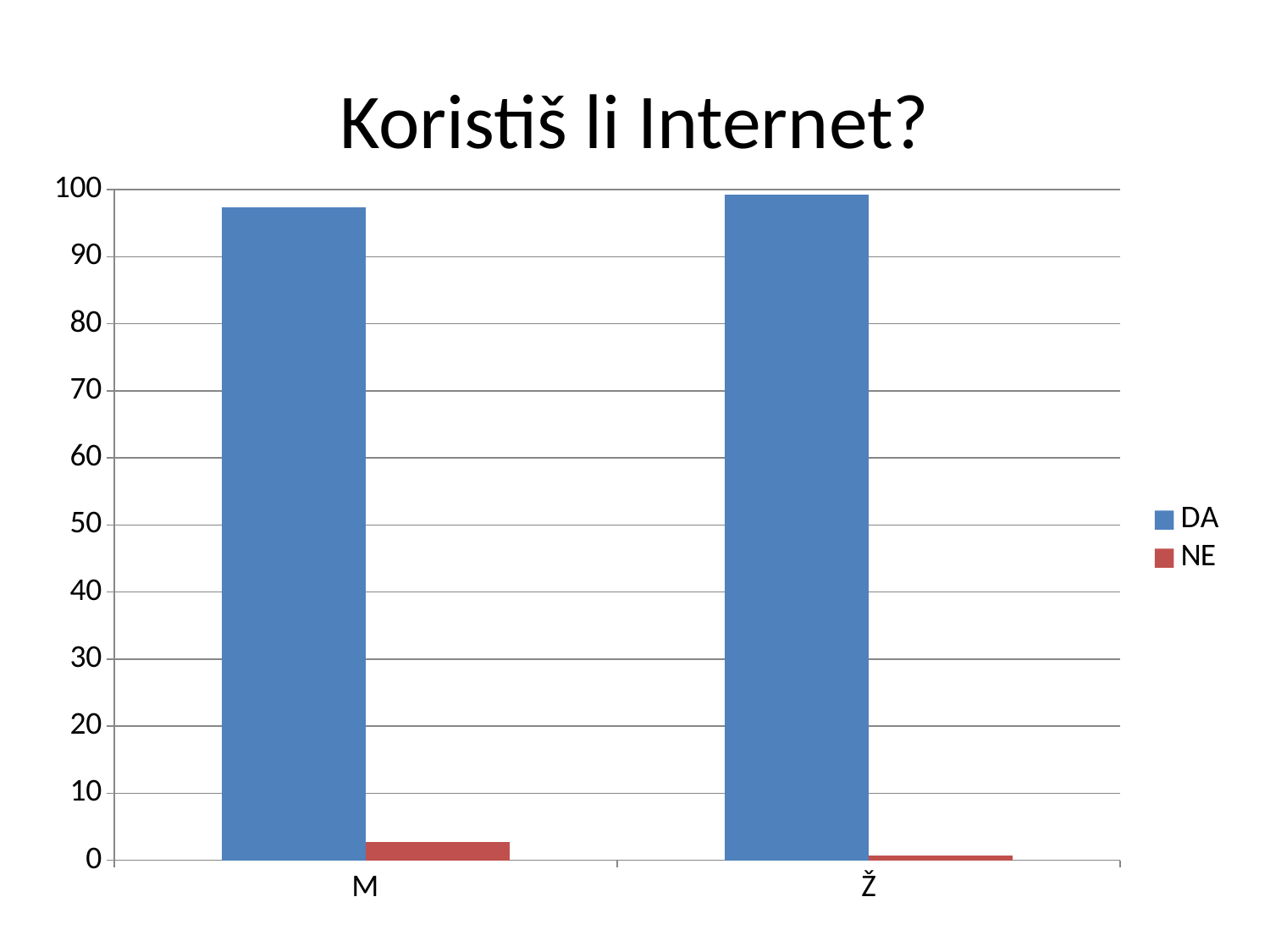
How many series does the legend list? 2 Which category has the higher NE value? M How many categories are shown on the x axis? 2 For category M, which is larger, DA or NE? DA Is the NE value for Ž greater or less than 10? less What kind of chart is shown on the slide? bar chart For category Ž, which is larger, DA or NE? DA What is the title of the chart? Koristiš li Internet? Is the NE value for M greater or less than 10? less Is the DA value for Ž greater or less than 90? greater Which series are listed in the legend? DA and NE